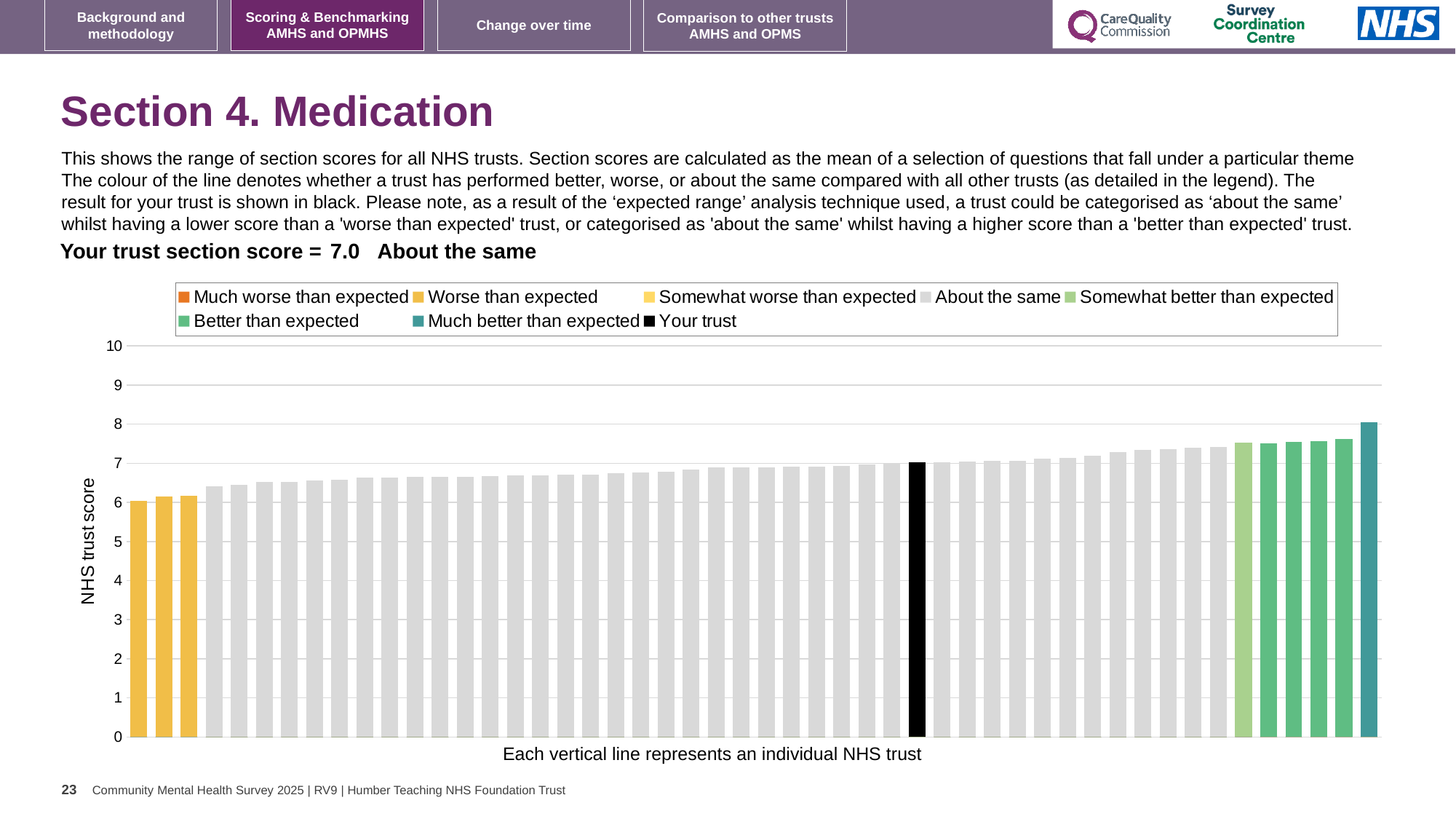
How many entries does the chart legend list? 8 Is the value of the tallest bar in the chart greater or less than 9? less How many bars are coloured as 'Worse than expected' (yellow) in the chart? 3 Is the value of the black 'Your trust' bar greater or less than 5? greater What kind of chart is shown on the slide? bar chart Which legend category does the tallest bar in the chart belong to? Much better than expected What is the label on the vertical axis of the chart? NHS trust score Is the value of the shortest bar in the chart greater or less than 5? greater Do the bar values rise or fall from left to right across the chart? rise Which legend category does the black bar represent? Your trust What is the section score for your trust shown on the slide? 7.0